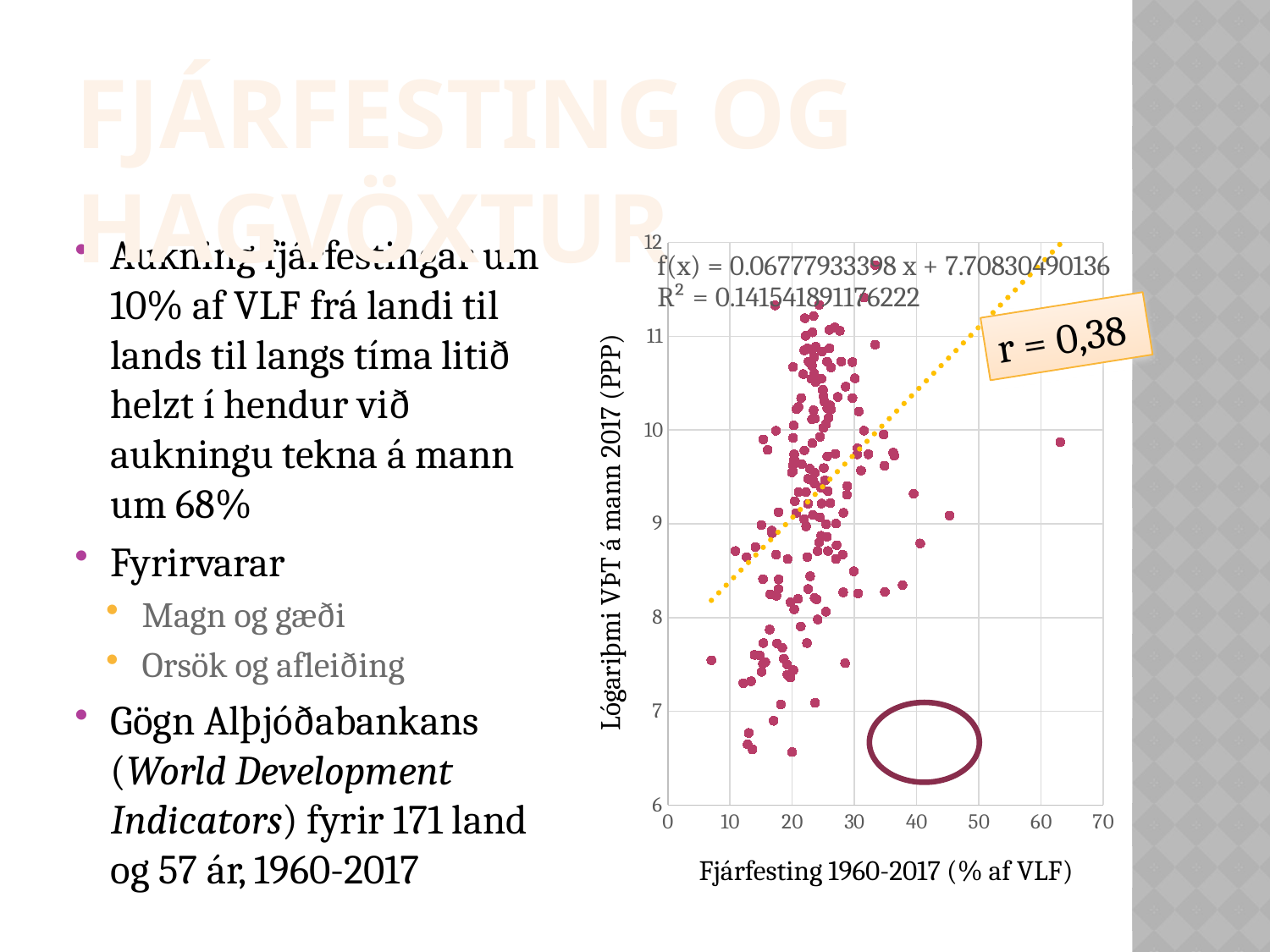
What is the lowest tick value shown on the y axis? 6 What R² value is printed on the chart? 0.141541891176222 What is the label of the y axis of the chart? Lógariþmi VÞT á mann 2017 (PPP) Is the y value of the rightmost (isolated) point on the chart greater or less than 9? greater Does the fitted trend line rise or fall as investment (x axis) increases? rises What is the label of the x axis of the chart? Fjárfesting 1960-2017 (% af VLF) Is the x value of the rightmost (isolated) point on the chart greater or less than 60? greater What correlation coefficient r is shown in the annotation box on the chart? r = 0,38 What is the slope of the fitted line f(x) printed on the chart? 0.06777933398 What kind of chart is shown on the slide? scatter plot What is the highest tick value shown on the x axis? 70 What is the intercept of the fitted line f(x) printed on the chart? 7.70830490136